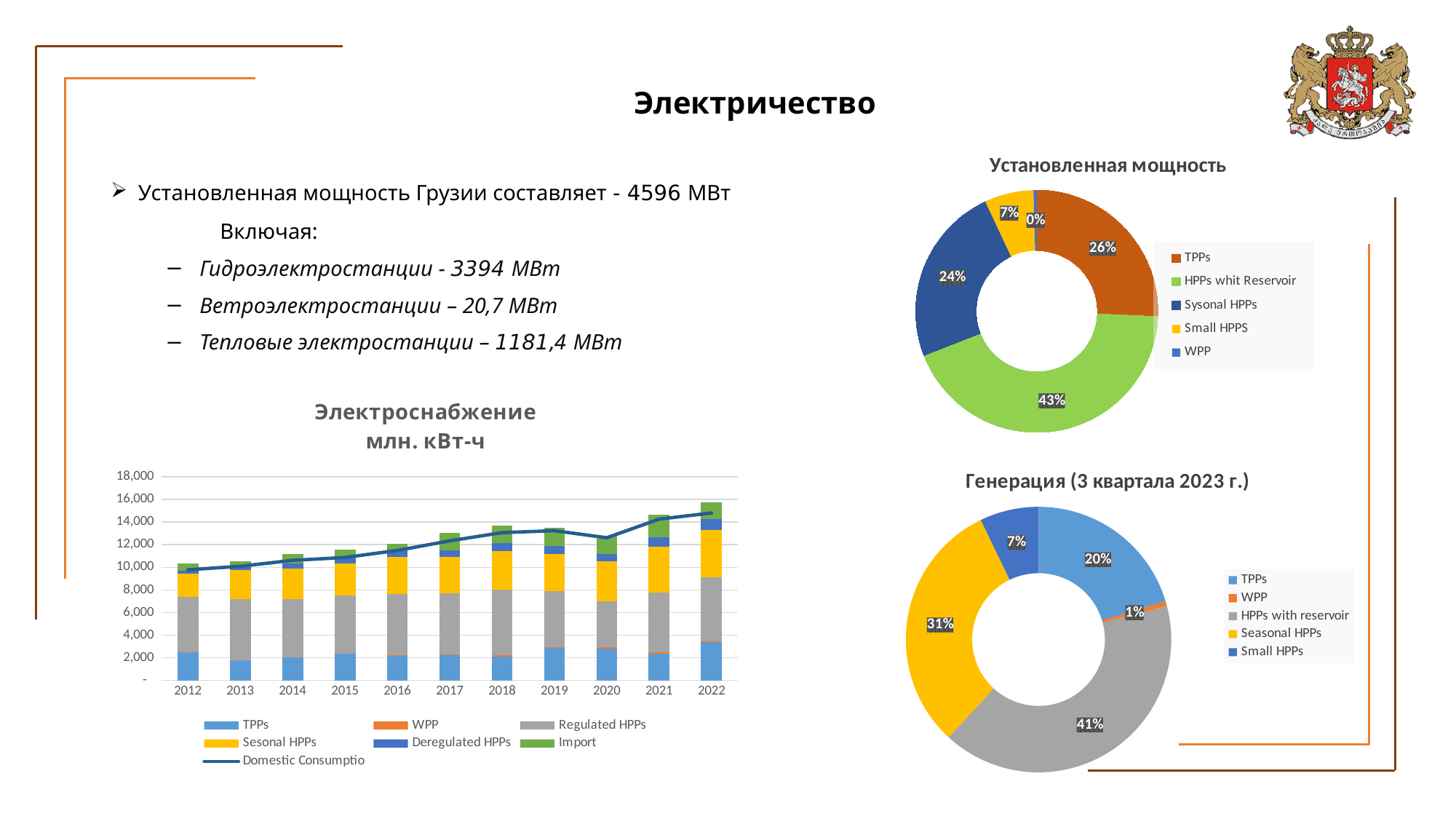
How many entries does the legend of the 'Установленная мощность' chart list? 5 In the 'Генерация (3 квартала 2023 г.)' chart, what share is shown for Seasonal HPPs? 31% In the 'Генерация (3 квартала 2023 г.)' chart, which category has the smallest share? WPP How many years are shown on the x axis of the 'Электроснабжение млн. кВт-ч' chart? 11 In the 'Генерация (3 квартала 2023 г.)' chart, what is the difference in percentage points between HPPs with reservoir and TPPs? 21 In the 'Установленная мощность' chart, which category has the largest share? HPPs whit Reservoir How many series does the legend of the 'Электроснабжение млн. кВт-ч' chart list? 7 In the 'Установленная мощность' chart, what percentage is labelled for TPPs? 26% In the 'Электроснабжение млн. кВт-ч' chart, is the total stacked value for 2022 greater or less than 14,000? greater In the 'Установленная мощность' chart, what share is shown for HPPs whit Reservoir? 43% In the 'Установленная мощность' chart, which is larger: Sysonal HPPs or Small HPPS? Sysonal HPPs What kind of chart is the 'Электроснабжение млн. кВт-ч' chart? Stacked bar chart with a line